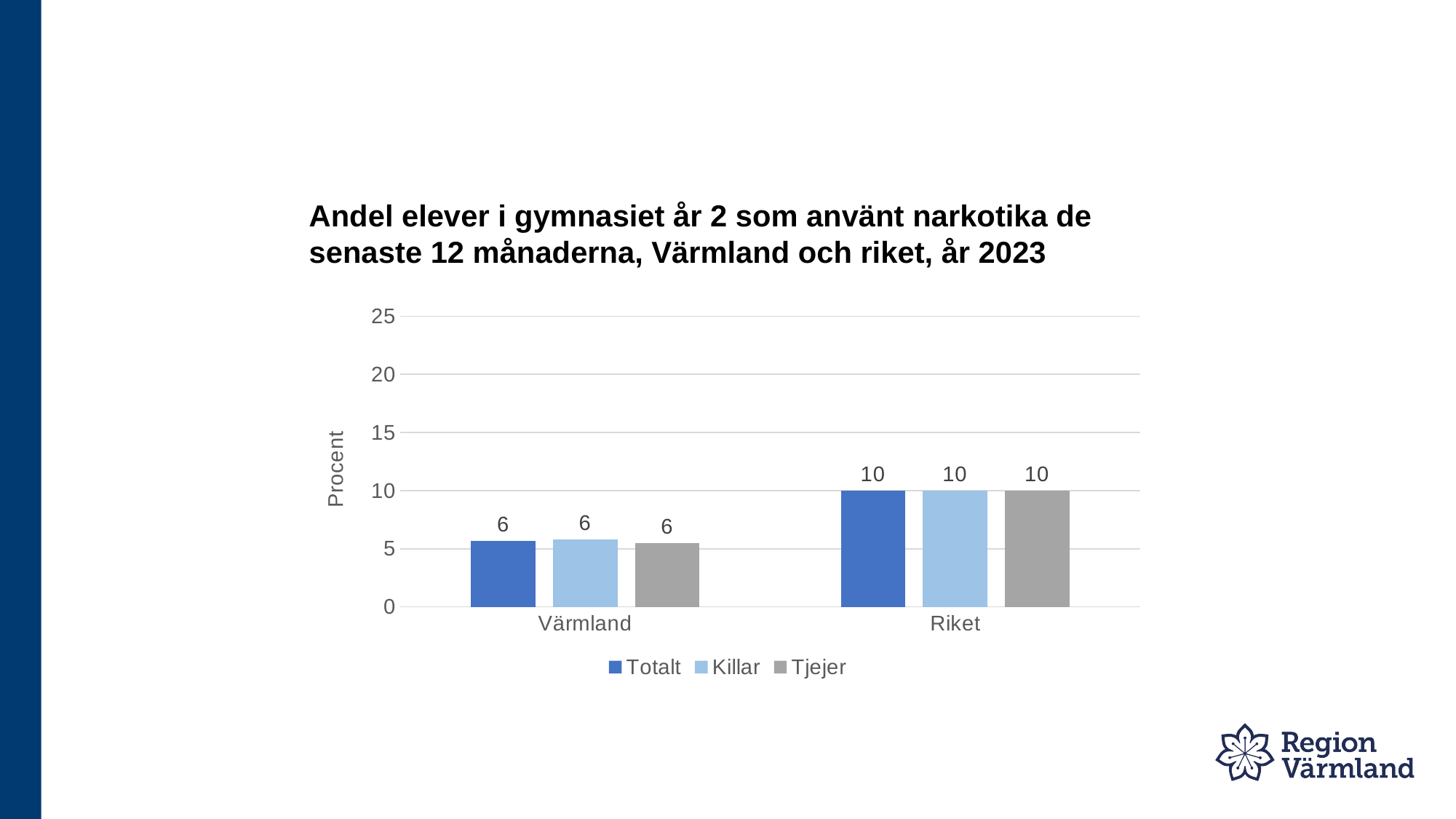
What is the value for Tjejer in Riket? 10 Which series is shown in grey in the legend? Tjejer What is the difference between the Killar value for Riket and the Killar value for Värmland? 4 What is the value for Tjejer in Värmland? 6 How many series does the legend list? 3 Which category has the higher value for Totalt, Värmland or Riket? Riket How many categories are shown on the x axis? 2 What is the label of the y axis? Procent What kind of chart is shown on the slide? bar chart What is the value for Killar in Riket? 10 What is the value for Totalt in Värmland? 6 Is the value for Totalt in Riket greater or less than 15? less